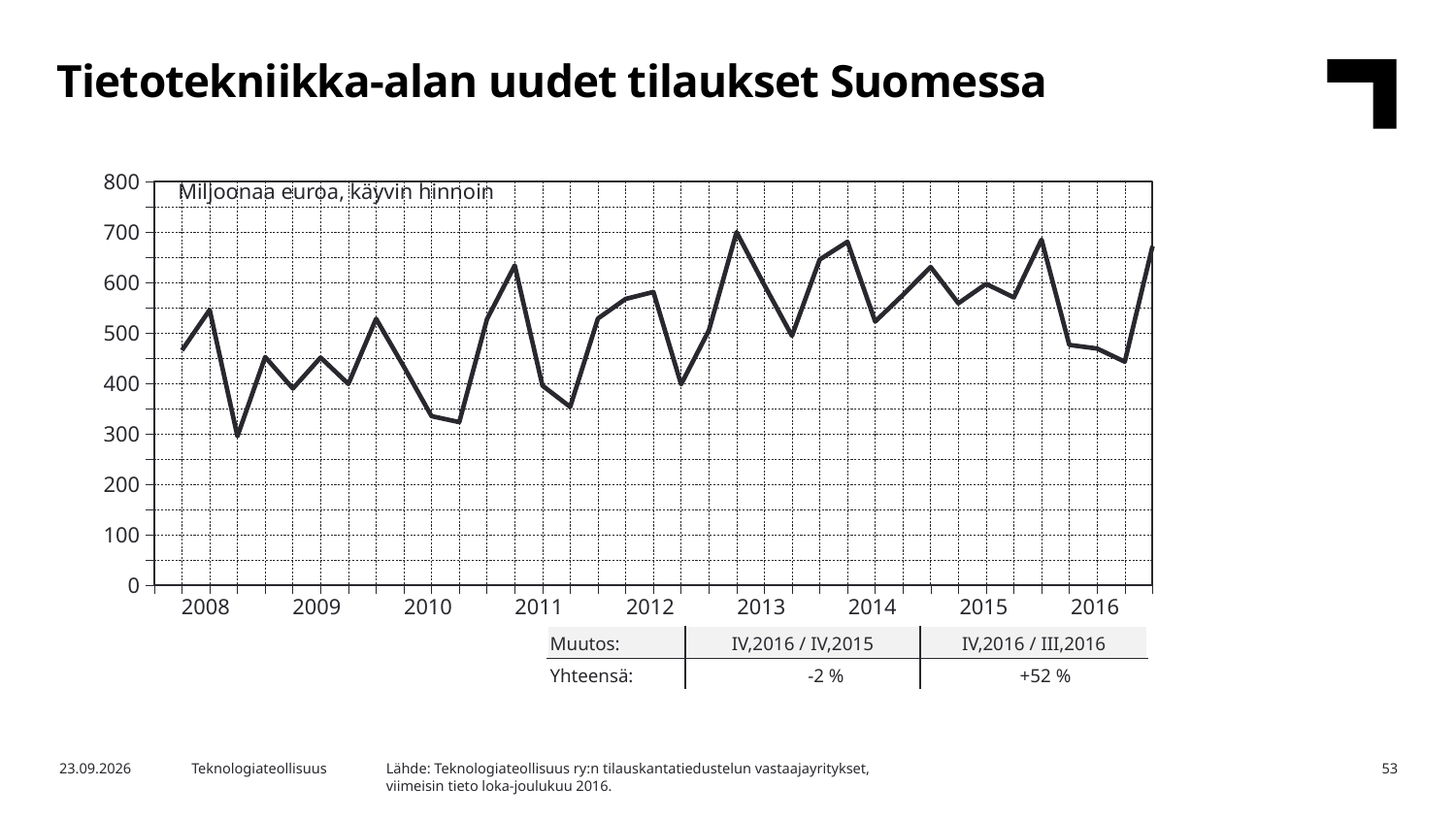
What kind of chart is shown on the slide? line chart Is the lowest value in 2010 greater or less than 400? less According to the table below the chart, what is the change IV,2016 / IV,2015? -2 % How many years are labelled on the x axis of the chart? 9 What unit is stated inside the chart area? Miljoonaa euroa, käyvin hinnoin According to the table below the chart, what is the change IV,2016 / III,2016? +52 % Is the lowest value in 2014 greater or less than 500? greater Is the lowest value in 2016 greater or less than 500? less What is the title of the chart on the slide? Tietotekniikka-alan uudet tilaukset Suomessa